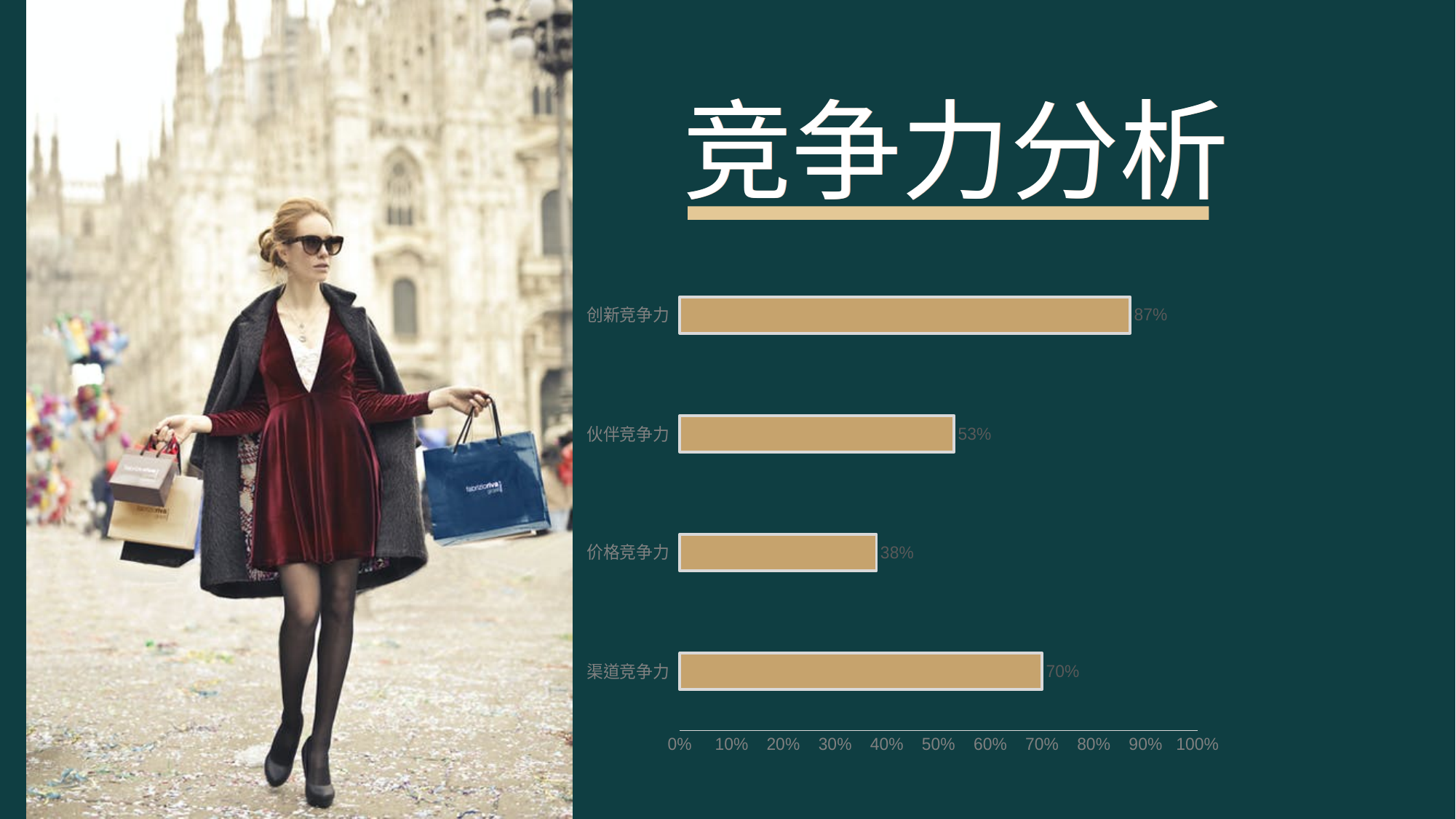
What is the title shown above the chart? 竞争力分析 Which category has the highest value? 创新竞争力 What is the value for 伙伴竞争力? 53% How many categories are shown in the chart? 4 Which is larger, the value for 伙伴竞争力 or the value for 渠道竞争力? 渠道竞争力 What is the difference between the values for 伙伴竞争力 and 价格竞争力? 15% What is the value for 渠道竞争力? 70% Which category has the lowest value? 价格竞争力 What is the difference between the values for 创新竞争力 and 渠道竞争力? 17% What kind of chart is shown on the slide? bar chart What is the value for 创新竞争力? 87% What is the value for 价格竞争力? 38%